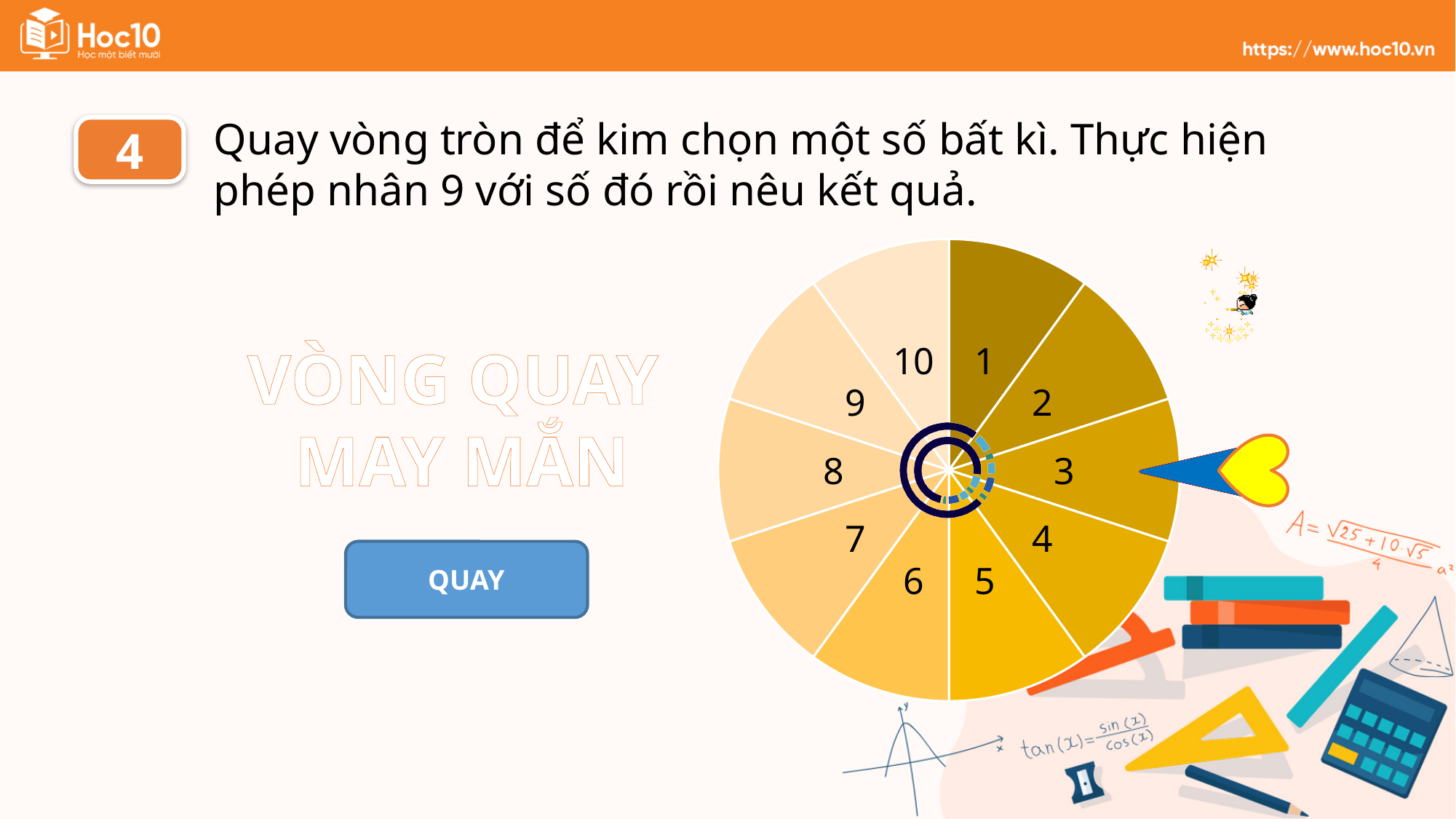
How many numbered slices does the wheel have? 10 Which number is the pointer on the right of the wheel pointing at? 3 What is the smallest number printed on the wheel? 1 What text is written on the blue button to the left of the wheel? QUAY What is the largest number printed on the wheel? 10 What kind of chart is the wheel on the slide drawn as? pie chart